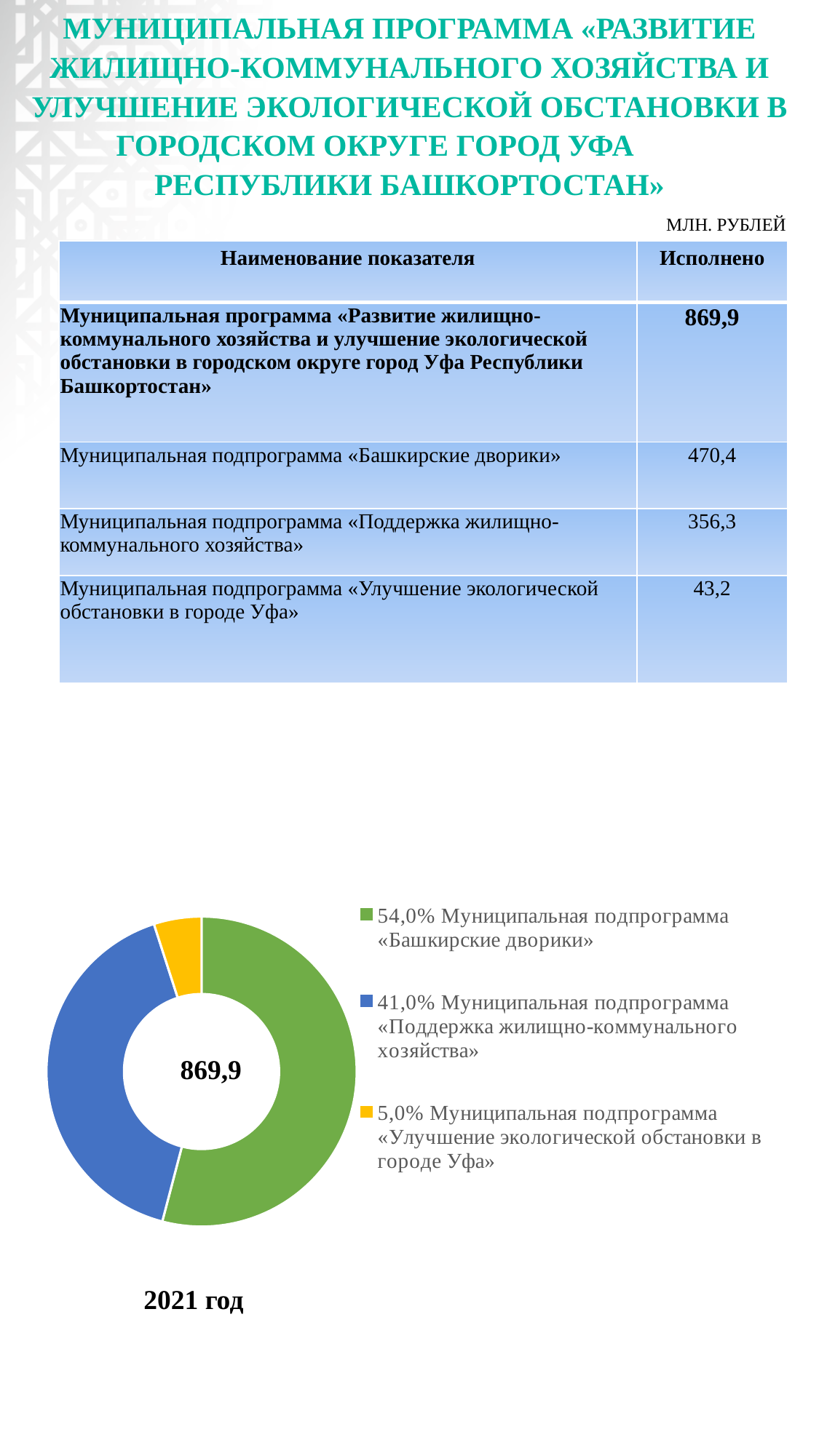
What share of the doughnut chart does the subprogramme «Поддержка жилищно-коммунального хозяйства» take? 41,0% What share of the doughnut chart does the subprogramme «Башкирские дворики» take? 54,0% What kind of chart is shown on the slide? Doughnut (pie) chart What share of the doughnut chart does the subprogramme «Улучшение экологической обстановки в городе Уфа» take? 5,0% What value is printed in the centre of the doughnut chart? 869,9 Which year is indicated below the doughnut chart? 2021 год Which slice is larger in the doughnut chart: «Башкирские дворики» or «Поддержка жилищно-коммунального хозяйства»? «Башкирские дворики» Which subprogramme has the smallest slice in the doughnut chart? Муниципальная подпрограмма «Улучшение экологической обстановки в городе Уфа» How many slices does the doughnut chart have? 3 What colour is the slice for «Улучшение экологической обстановки в городе Уфа» in the doughnut chart? Yellow By how many percentage points does the share of «Башкирские дворики» exceed the share of «Поддержка жилищно-коммунального хозяйства» in the doughnut chart? 13,0% Which subprogramme has the largest slice in the doughnut chart? Муниципальная подпрограмма «Башкирские дворики»